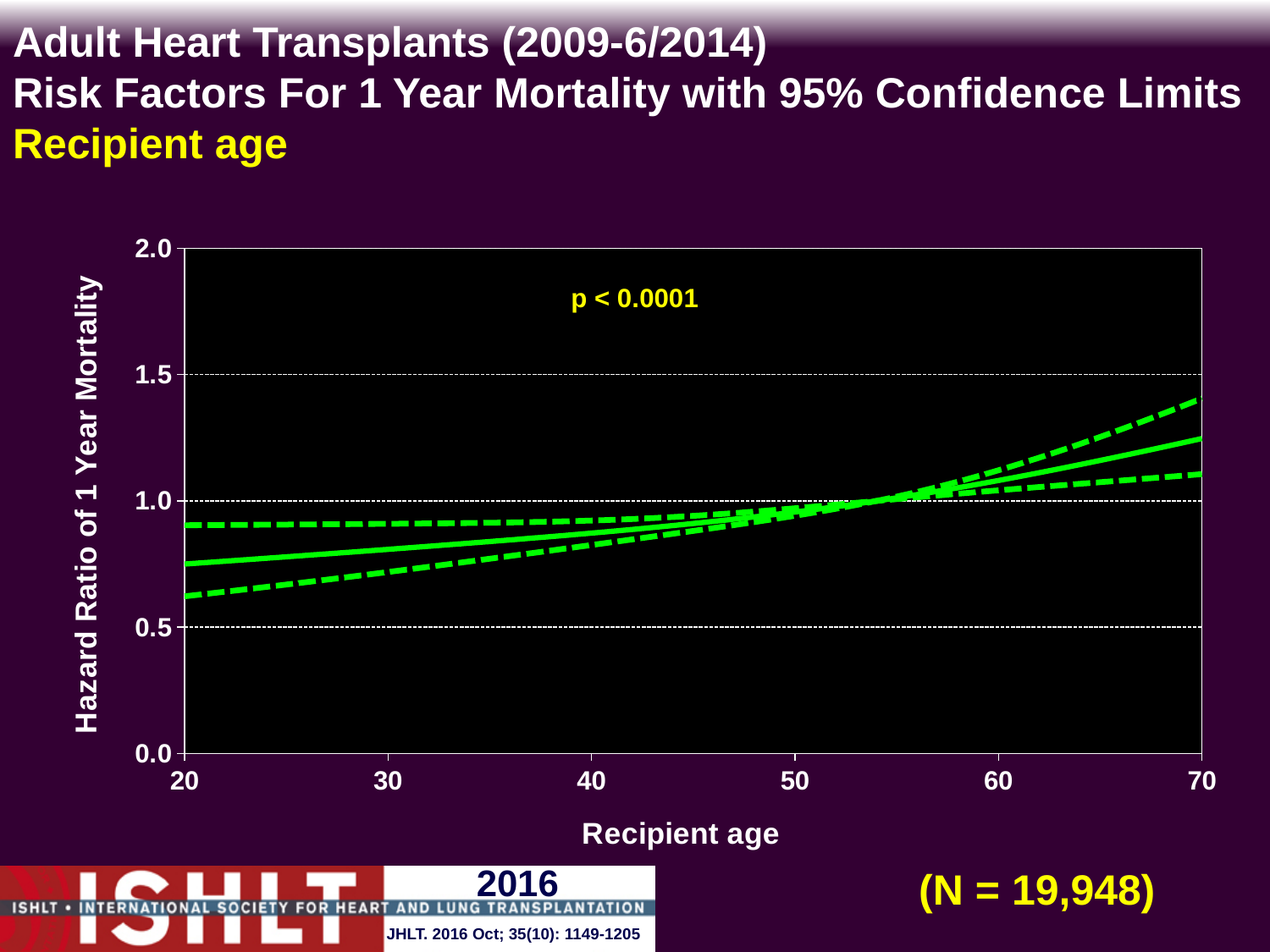
Is the hazard ratio (solid line) at recipient age 50 greater or less than 1.0? less What p-value is printed on the chart? p < 0.0001 How many lines are plotted on the chart? 3 Is the hazard ratio (solid line) at recipient age 20 greater or less than 1.0? less Is the upper confidence limit (upper dashed line) at recipient age 70 greater or less than 1.5? less What kind of chart is shown on the slide? line chart What is the sample size (N) shown on the slide? N = 19,948 Which recipient age has the higher hazard ratio on the solid line, 20 or 70? 70 Does the hazard ratio of 1 year mortality rise or fall as recipient age increases from 20 to 70? rise